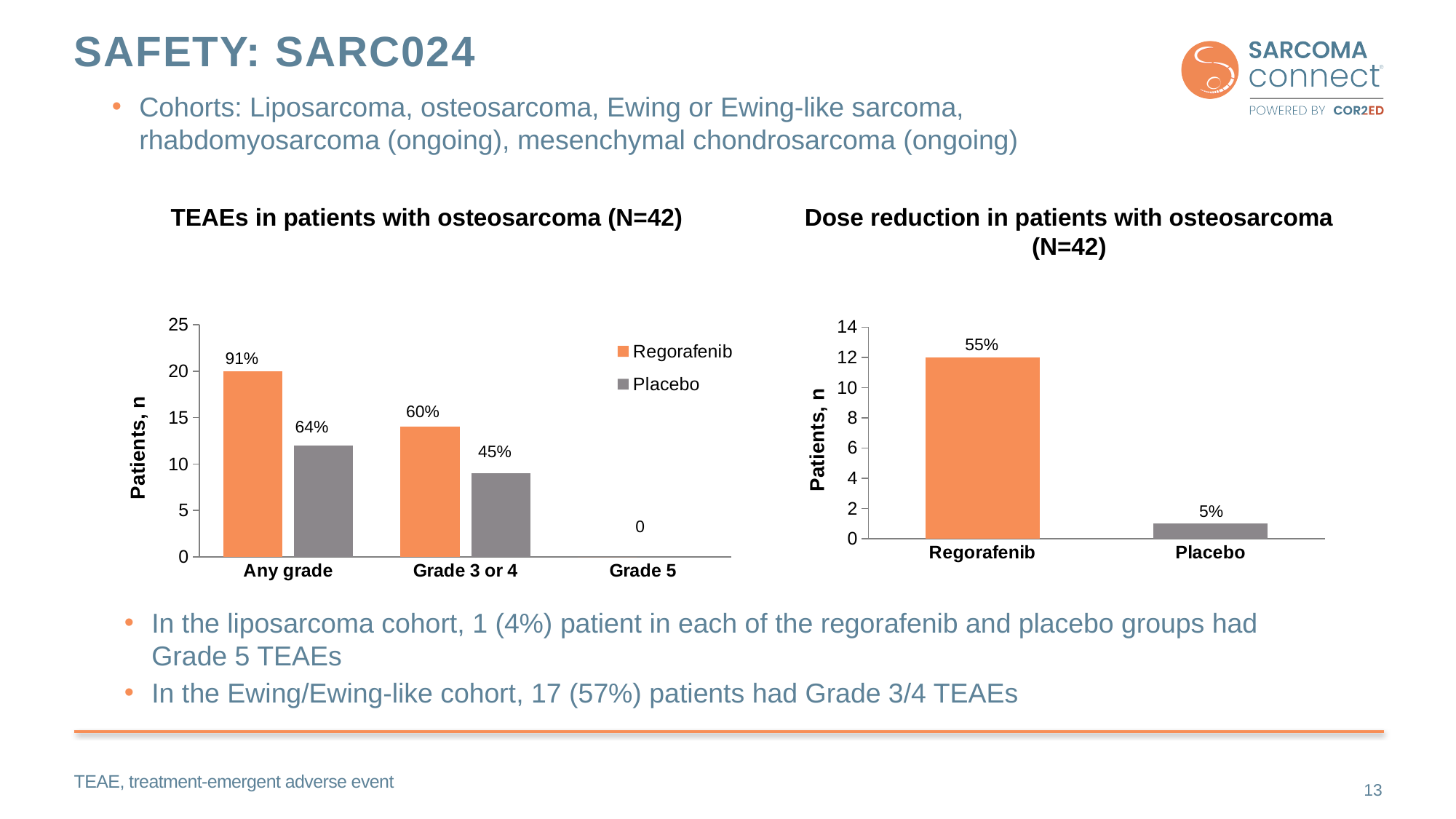
In the TEAEs in patients with osteosarcoma chart, what value is shown for Grade 5? 0 In the TEAEs in patients with osteosarcoma chart, what data label is shown on the Regorafenib bar for Any grade? 91% How many categories are shown on the x axis of the TEAEs in patients with osteosarcoma chart? 3 In the TEAEs in patients with osteosarcoma chart, what data label is shown on the Placebo bar for Grade 3 or 4? 45% In the TEAEs in patients with osteosarcoma chart, which series has the taller bar for Any grade, Regorafenib or Placebo? Regorafenib In the Dose reduction in patients with osteosarcoma chart, which group has the higher number of patients with dose reduction? Regorafenib What kind of chart is the Dose reduction in patients with osteosarcoma chart? Bar chart In the TEAEs in patients with osteosarcoma chart, is the number of Placebo patients with Grade 3 or 4 TEAEs greater or less than 10? less In the Dose reduction in patients with osteosarcoma chart, what data label is shown on the Regorafenib bar? 55% In the Dose reduction in patients with osteosarcoma chart, what data label is shown on the Placebo bar? 5% How many series does the legend of the TEAEs in patients with osteosarcoma chart list? 2 In the TEAEs in patients with osteosarcoma chart, what data label is shown on the Placebo bar for Any grade? 64%